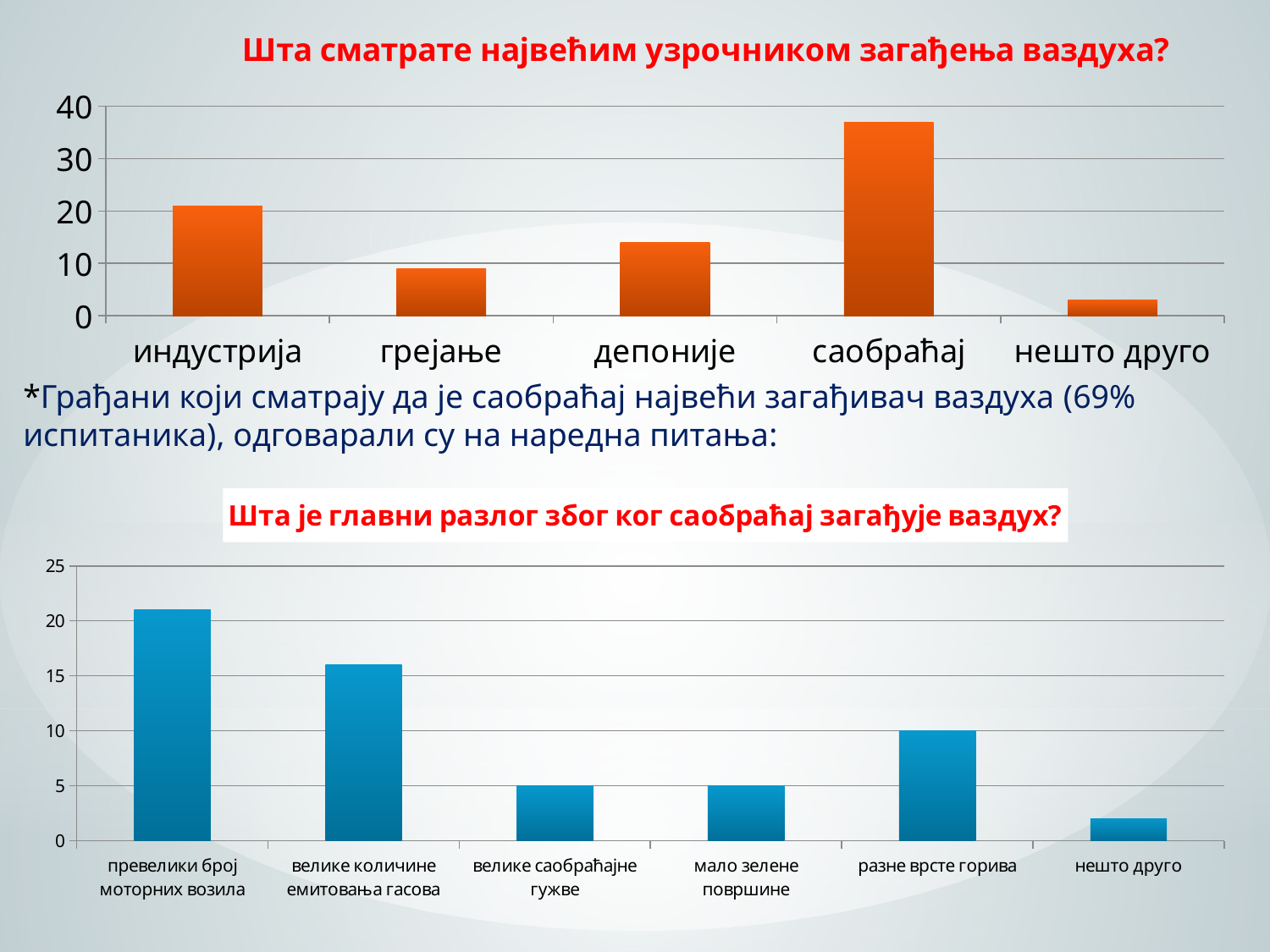
What kind of chart is the top chart 'Шта сматрате највећим узрочником загађења ваздуха?'? bar chart In the top chart 'Шта сматрате највећим узрочником загађења ваздуха?', which is larger: индустрија or депоније? индустрија In the top chart 'Шта сматрате највећим узрочником загађења ваздуха?', is the value for саобраћај greater or less than 30? greater In the bottom chart 'Шта је главни разлог због ког саобраћај загађује ваздух?', is the value for велике количине емитовања гасова greater or less than 15? greater In the top chart 'Шта сматрате највећим узрочником загађења ваздуха?', which category has the highest value? саобраћај How many categories are shown in the top chart 'Шта сматрате највећим узрочником загађења ваздуха?'? 5 In the top chart 'Шта сматрате највећим узрочником загађења ваздуха?', which category has the lowest value? нешто друго How many categories are shown in the bottom chart 'Шта је главни разлог због ког саобраћај загађује ваздух?'? 6 In the bottom chart 'Шта је главни разлог због ког саобраћај загађује ваздух?', what is the value for разне врсте горива? 10 In the top chart 'Шта сматрате највећим узрочником загађења ваздуха?', is the value for грејање greater or less than 10? less In the bottom chart 'Шта је главни разлог због ког саобраћај загађује ваздух?', what is the value for велике саобраћајне гужве? 5 In the bottom chart 'Шта је главни разлог због ког саобраћај загађује ваздух?', which category has the highest value? превелики број моторних возила